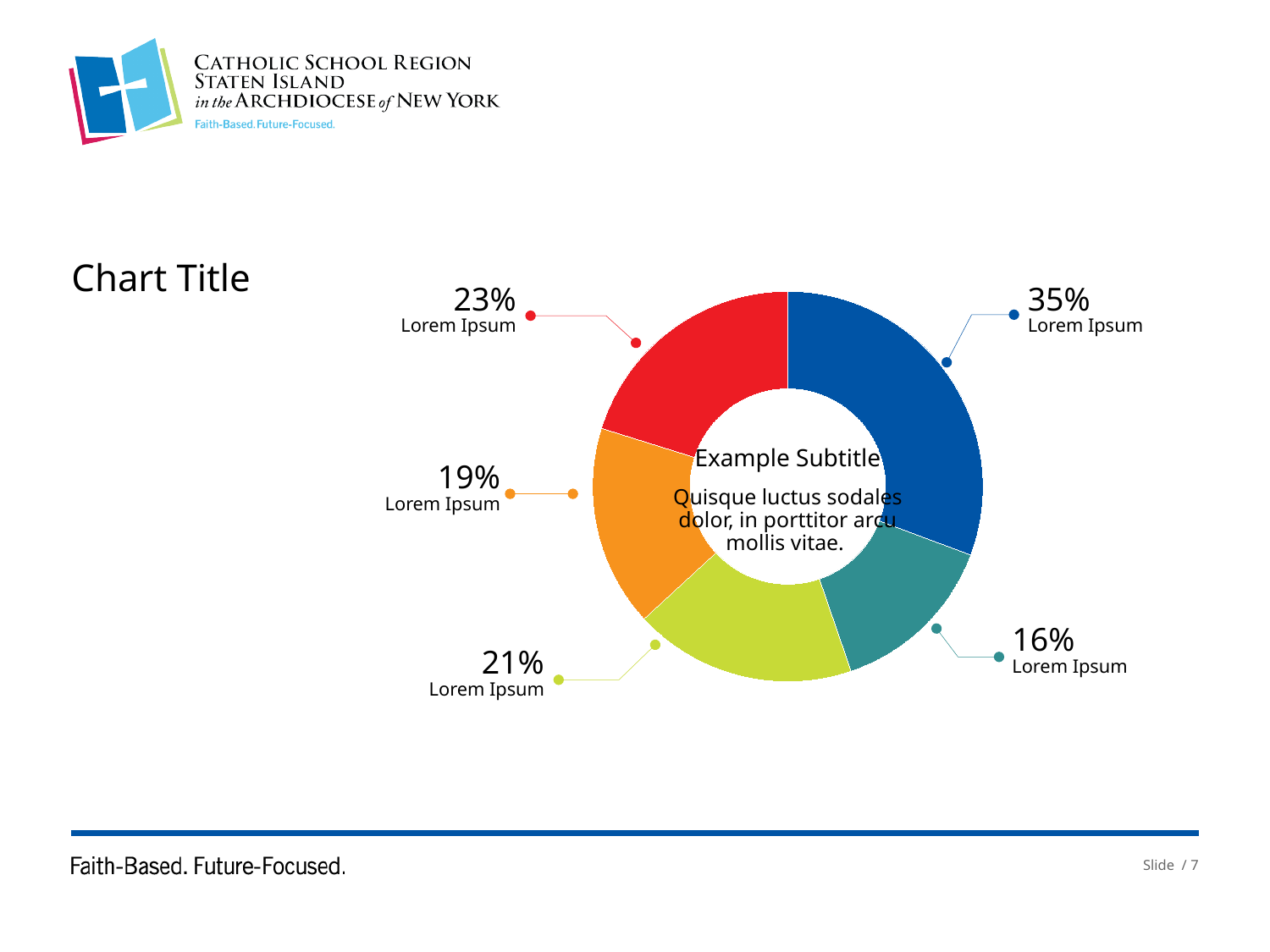
What is the difference in percentage points between the blue slice and the teal slice? 19 What percentage is labelled on the lime green slice of the pie chart? 21% Which slice of the pie chart has the largest share? The blue slice, 35% What percentage is labelled on the red slice of the pie chart? 23% What subtitle text appears in the centre of the donut chart? Example Subtitle What is the title of the chart? Chart Title How many slices does the pie chart have? 5 What share of the pie does the blue slice represent? 35% What kind of chart is shown on the slide? Pie chart (donut) Which is larger, the red slice or the orange slice? The red slice What percentage is labelled on the orange slice of the pie chart? 19% Which slice of the pie chart has the smallest share? The teal slice, 16%